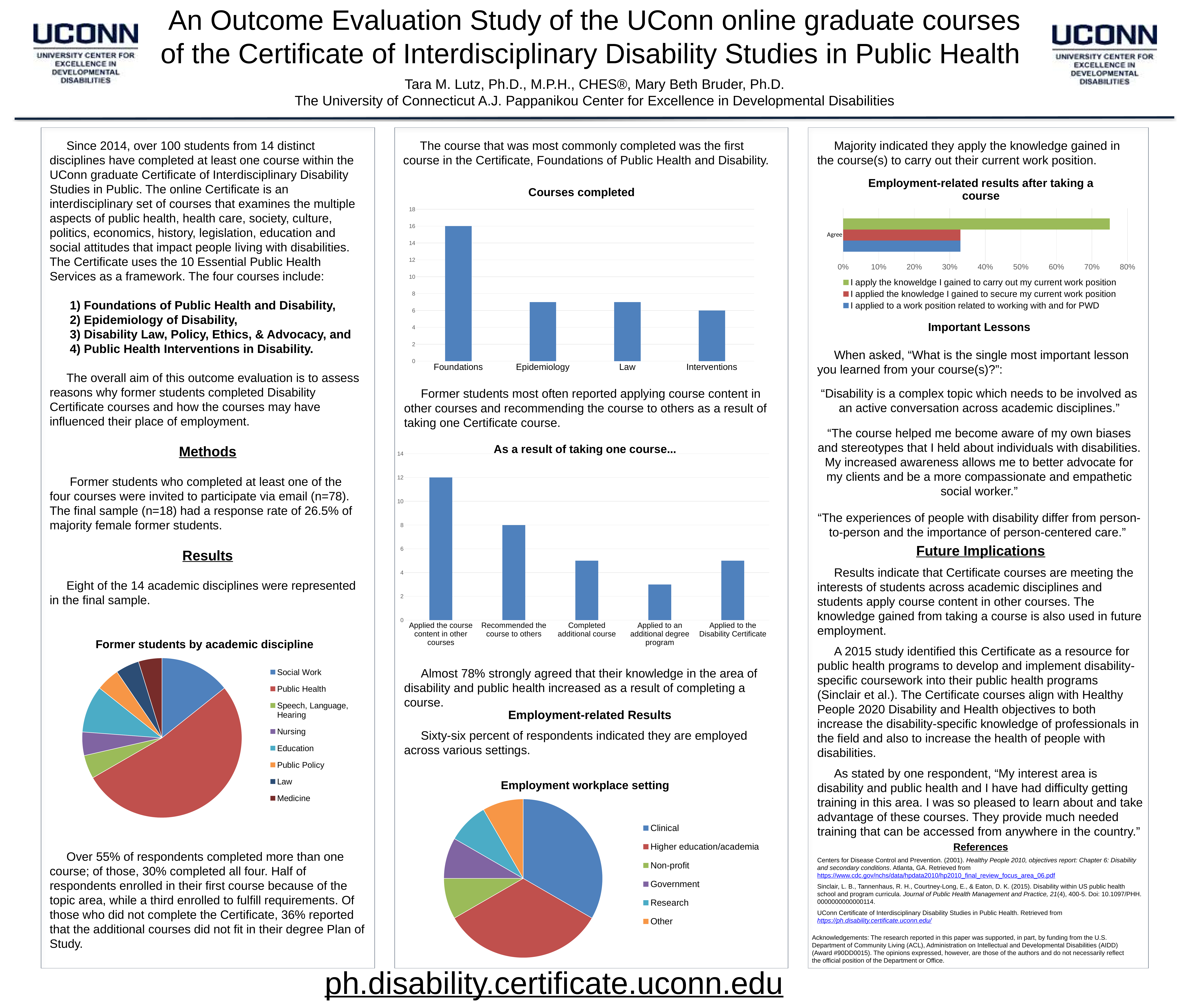
In the "Employment-related results after taking a course" chart, is the value for "I apply the knoweldge I gained to carry out my current work position" greater or less than 70%? greater In the "Courses completed" chart, which course was completed by the fewest students? Interventions In the "Courses completed" chart, how many students completed Foundations? 16 In the "As a result of taking one course..." chart, what is the value for "Recommended the course to others"? 8 In the "Courses completed" chart, which course was completed by the most students? Foundations In the "Courses completed" chart, how many students completed Interventions? 6 In the "Courses completed" chart, how many courses are shown on the x axis? 4 In the "As a result of taking one course..." chart, which category has the lowest value? Applied to an additional degree program In the "As a result of taking one course..." chart, what is the value for "Applied the course content in other courses"? 12 In the "As a result of taking one course..." chart, what is the difference between "Applied the course content in other courses" and "Recommended the course to others"? 4 How many series does the legend of the "Employment-related results after taking a course" chart list? 3 In the "Former students by academic discipline" pie chart, which discipline has the largest slice? Public Health